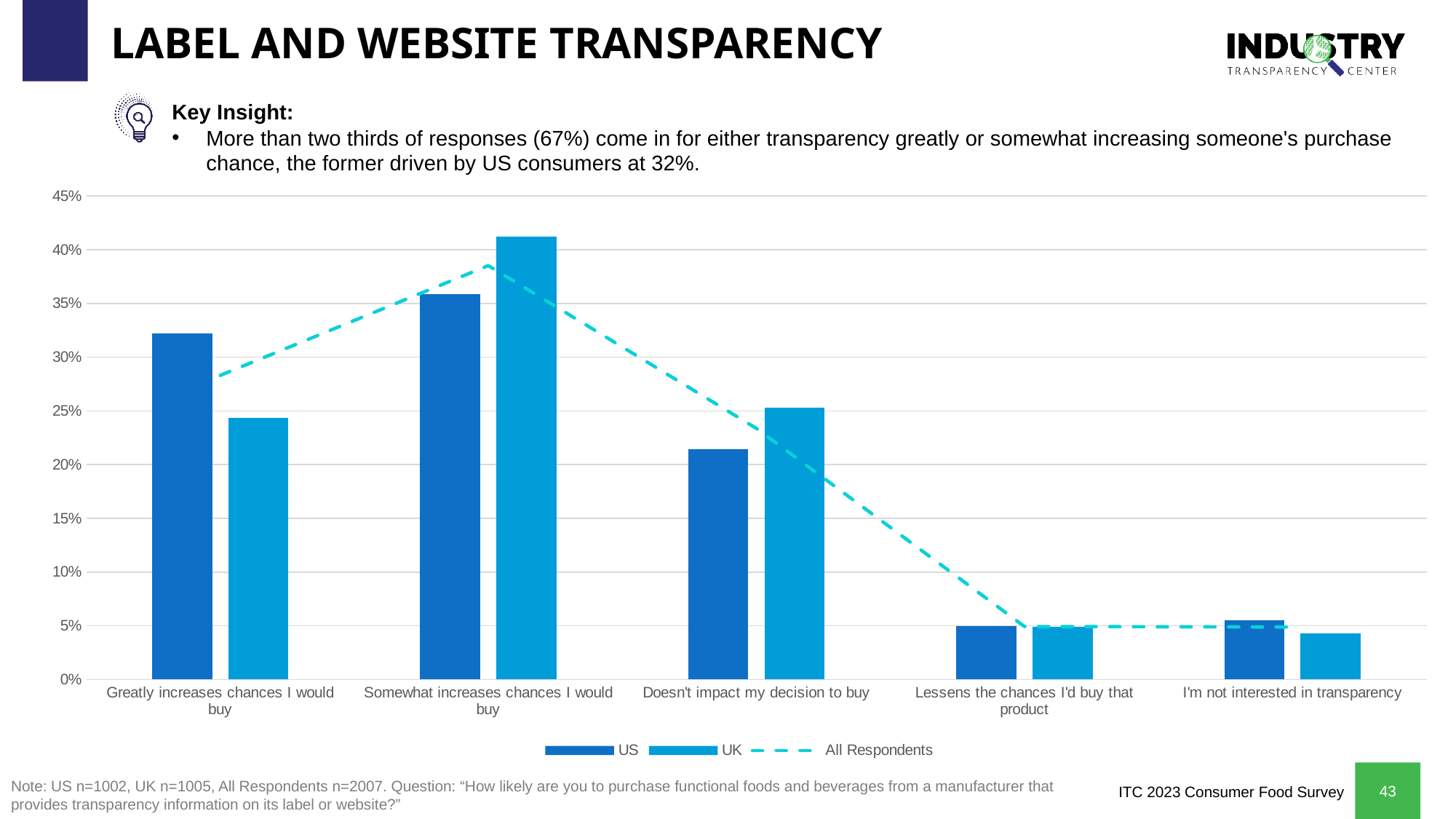
For 'Greatly increases chances I would buy', which is larger, the US bar or the UK bar? US What kind of chart is shown on the slide? combination bar and line chart Is the UK value for 'I'm not interested in transparency' greater or less than 5%? less Is the US value for 'Greatly increases chances I would buy' greater or less than 30%? greater Which category has the tallest bar in the chart? Somewhat increases chances I would buy For 'Somewhat increases chances I would buy', which is larger, the US bar or the UK bar? UK Which category has the lowest UK bar in the chart? I'm not interested in transparency Is the UK value for 'Somewhat increases chances I would buy' greater or less than 40%? greater How many series does the chart legend list? 3 Which series is drawn as a dashed line in the chart? All Respondents Does the All Respondents line rise or fall from 'Somewhat increases chances I would buy' to 'Lessens the chances I'd buy that product'? fall How many categories are shown along the x axis of the chart? 5